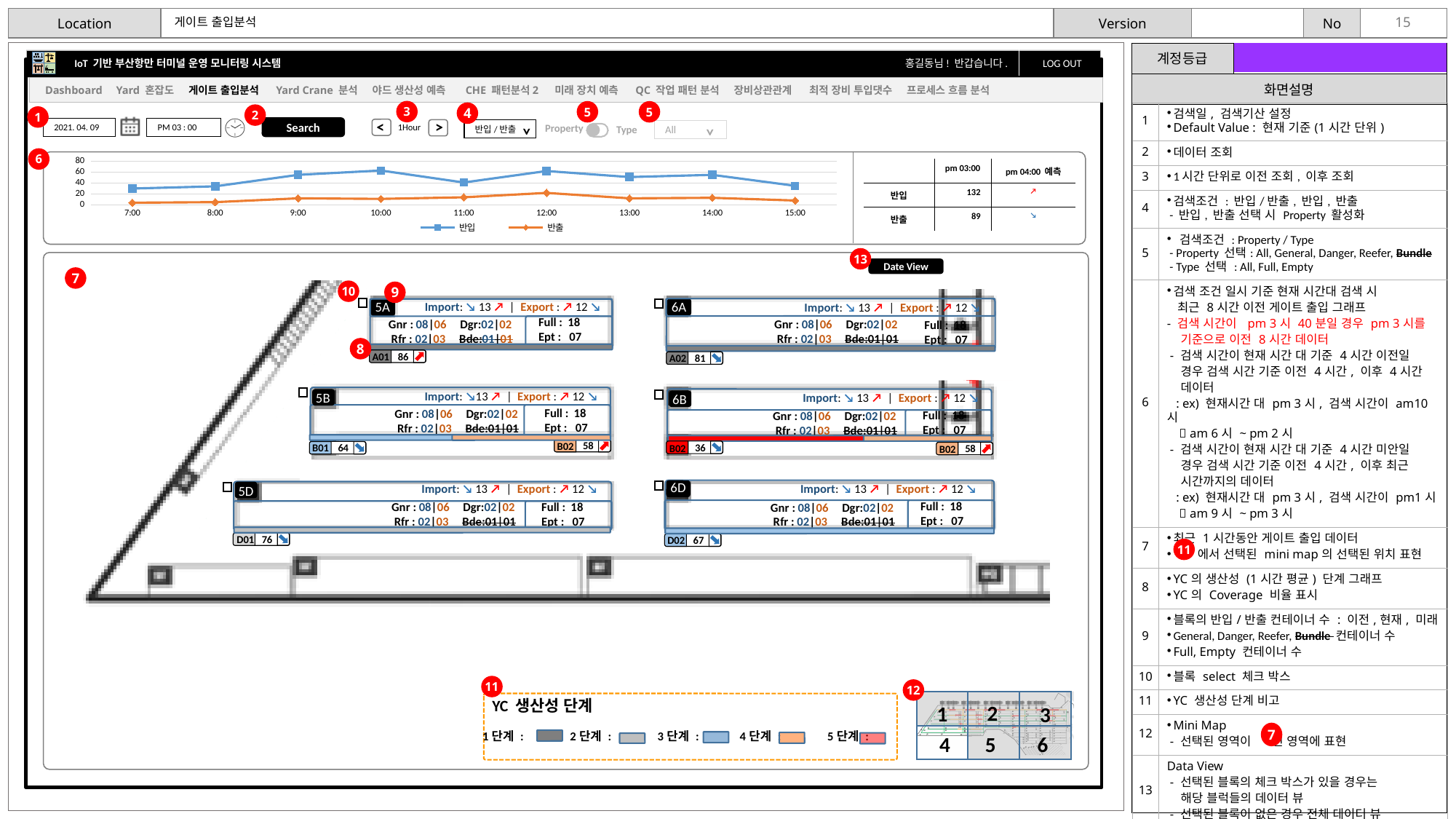
How many series does the legend of the line chart list? 2 In the line chart, is the value for 반출 at 12:00 greater or less than 40? less In the line chart, is the value for 반출 at 9:00 greater or less than 20? less How many time points are plotted along the x axis of the line chart? 9 In the line chart, is the value for 반입 at 7:00 greater or less than 40? less In the line chart, which series is drawn in blue? 반입 In the line chart, which series has the larger value at 12:00, 반입 or 반출? 반입 What kind of chart is shown at the top of the slide? line chart In the line chart, at which time does 반출 reach its highest value? 12:00 What is the highest value shown on the y axis of the line chart? 80 In the line chart, does the 반입 series rise or fall from 7:00 to 10:00? rise